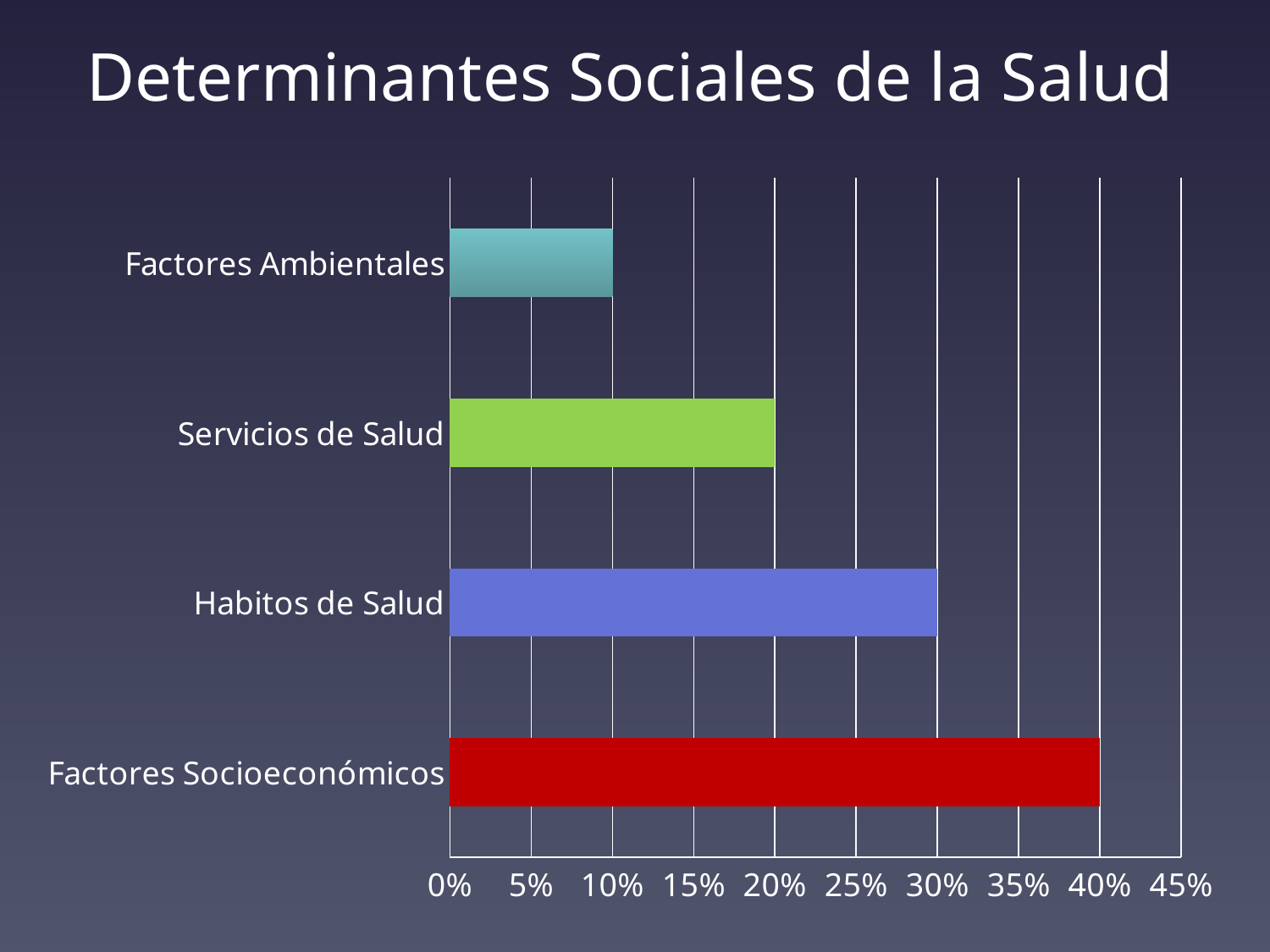
Is the value for Habitos de Salud greater or less than 25%? greater What is the title of the slide? Determinantes Sociales de la Salud Which is larger, the value for Habitos de Salud or the value for Servicios de Salud? Habitos de Salud What is the value for Servicios de Salud? 20% How many categories are shown in the chart? 4 What is the value for Habitos de Salud? 30% What kind of chart is shown on the slide? Bar chart What is the difference between the values for Factores Socioeconómicos and Servicios de Salud? 20% What is the value for Factores Socioeconómicos? 40% Which category has the lowest value? Factores Ambientales Which category has the highest value? Factores Socioeconómicos What is the value for Factores Ambientales? 10%